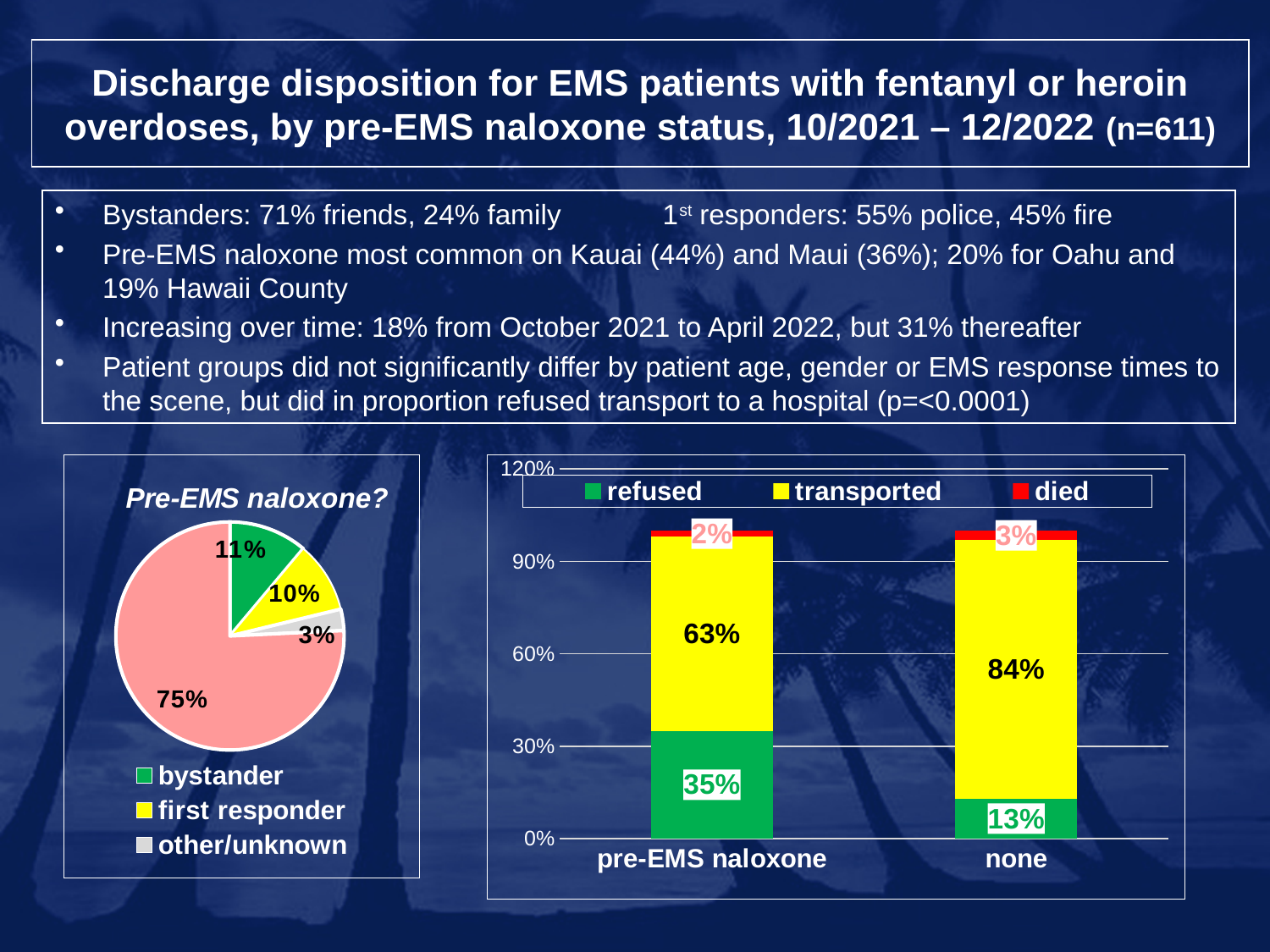
In the stacked bar chart on the right, what percentage of the none group was transported? 84% In the pie chart titled 'Pre-EMS naloxone?', what is the value of the largest slice? 75% In the pie chart titled 'Pre-EMS naloxone?', what share of the pie is the first responder slice? 10% In the stacked bar chart on the right, what percentage of the pre-EMS naloxone group refused? 35% In the pie chart titled 'Pre-EMS naloxone?', what share of the pie is the other/unknown slice? 3% In the pie chart titled 'Pre-EMS naloxone?', what share of the pie is the bystander slice? 11% In the stacked bar chart on the right, how many series does the legend list? 3 In the pie chart titled 'Pre-EMS naloxone?', how many entries does the legend list? 3 What type of chart is shown on the right side of the slide? stacked bar chart In the stacked bar chart on the right, what is the difference between the refused percentages for the pre-EMS naloxone group and the none group? 22% In the stacked bar chart on the right, what percentage of the pre-EMS naloxone group died? 2% In the stacked bar chart on the right, which group has the larger transported percentage, pre-EMS naloxone or none? none